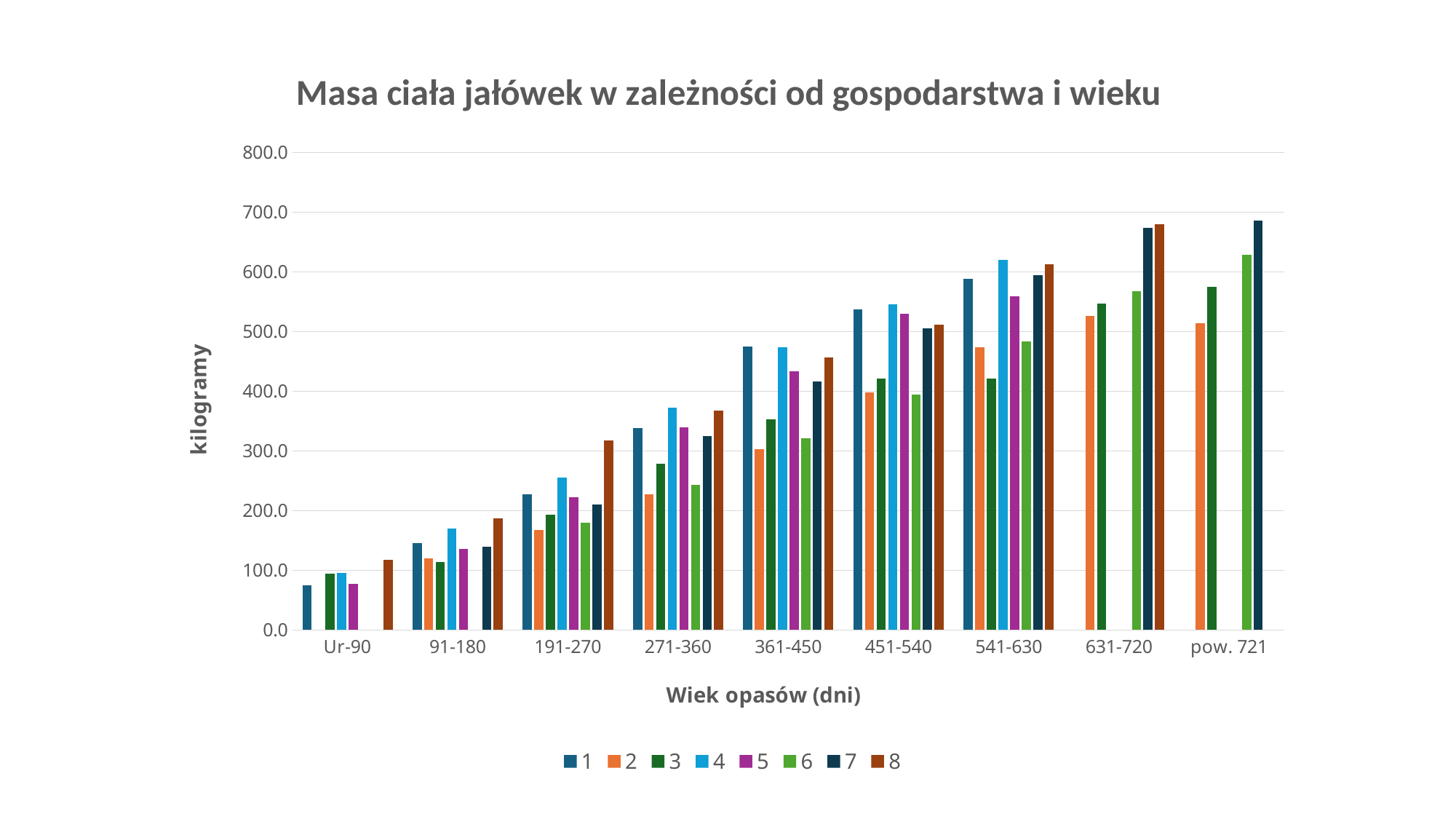
Do the values for series 1 rise or fall from Ur-90 to 541-630? rise Is the value for series 7 in the pow. 721 category greater or less than 700? less Which series has the highest value in the 191-270 category? 8 How many age categories are shown on the x axis? 9 Is the value for series 4 in the 541-630 category greater or less than 600? greater Is the value for series 1 in the 451-540 category greater or less than 500? greater In the 271-360 category, which is larger: the value for series 4 or series 2? series 4 How many series does the legend list? 8 What is the label of the y axis? kilogramy What kind of chart is shown on the slide? bar chart Which series has the lowest value in the 541-630 category? 3